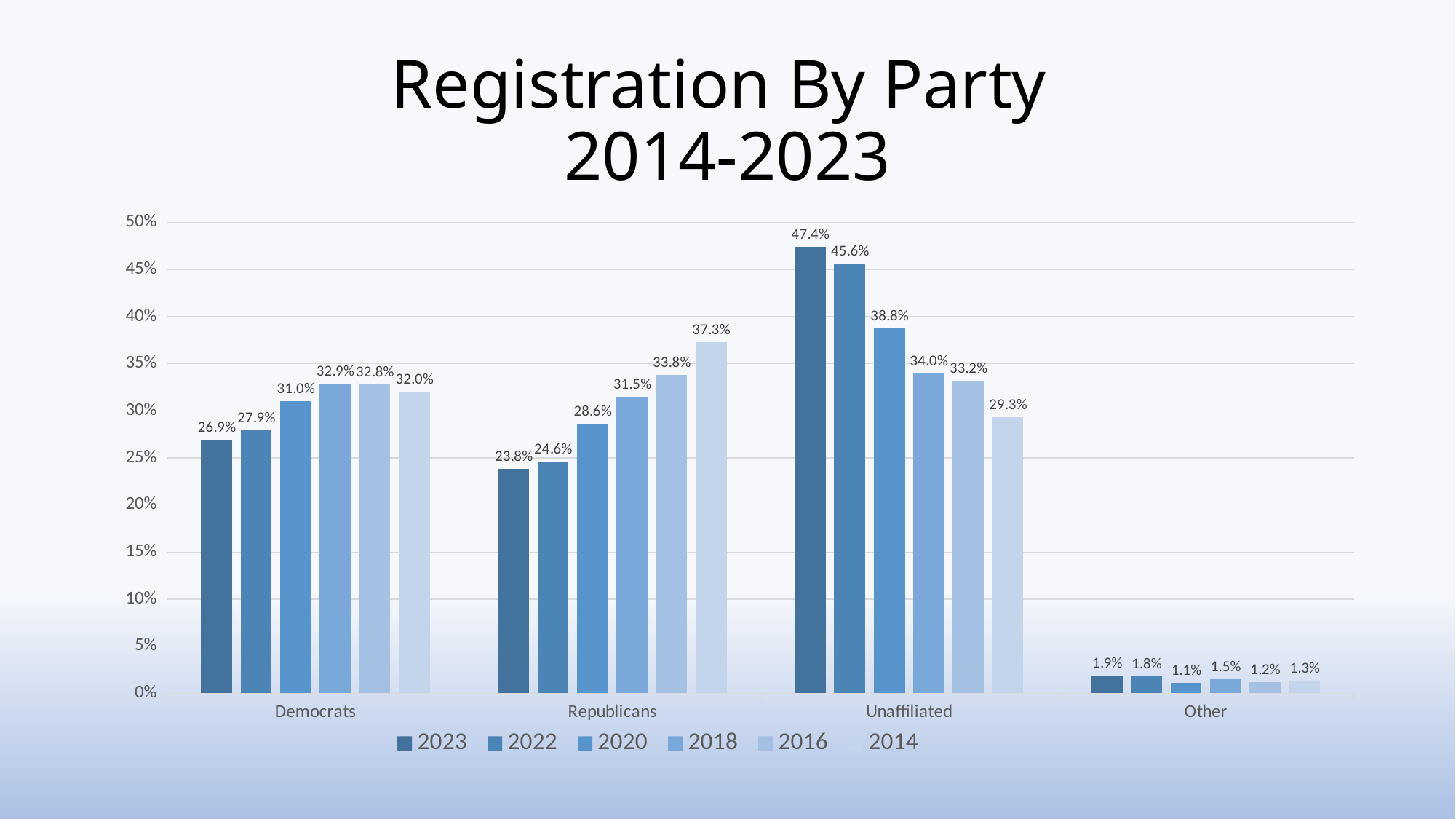
What is the difference between the 2023 and 2014 values for Unaffiliated? 18.1% What is the 2014 registration value for Republicans? 37.3% Which category has the highest 2023 value? Unaffiliated Which is larger, the 2018 value for Democrats or the 2018 value for Republicans? Democrats What kind of chart is shown on the slide? Bar chart What is the 2023 registration value for Unaffiliated? 47.4% What is the title of the chart? Registration By Party 2014-2023 What is the 2020 registration value for Democrats? 31.0% How many categories are shown on the x axis? 4 Which category has the lowest 2016 value? Other How many series does the legend list? 6 Do the Republicans values rise or fall from 2014 to 2023? Fall